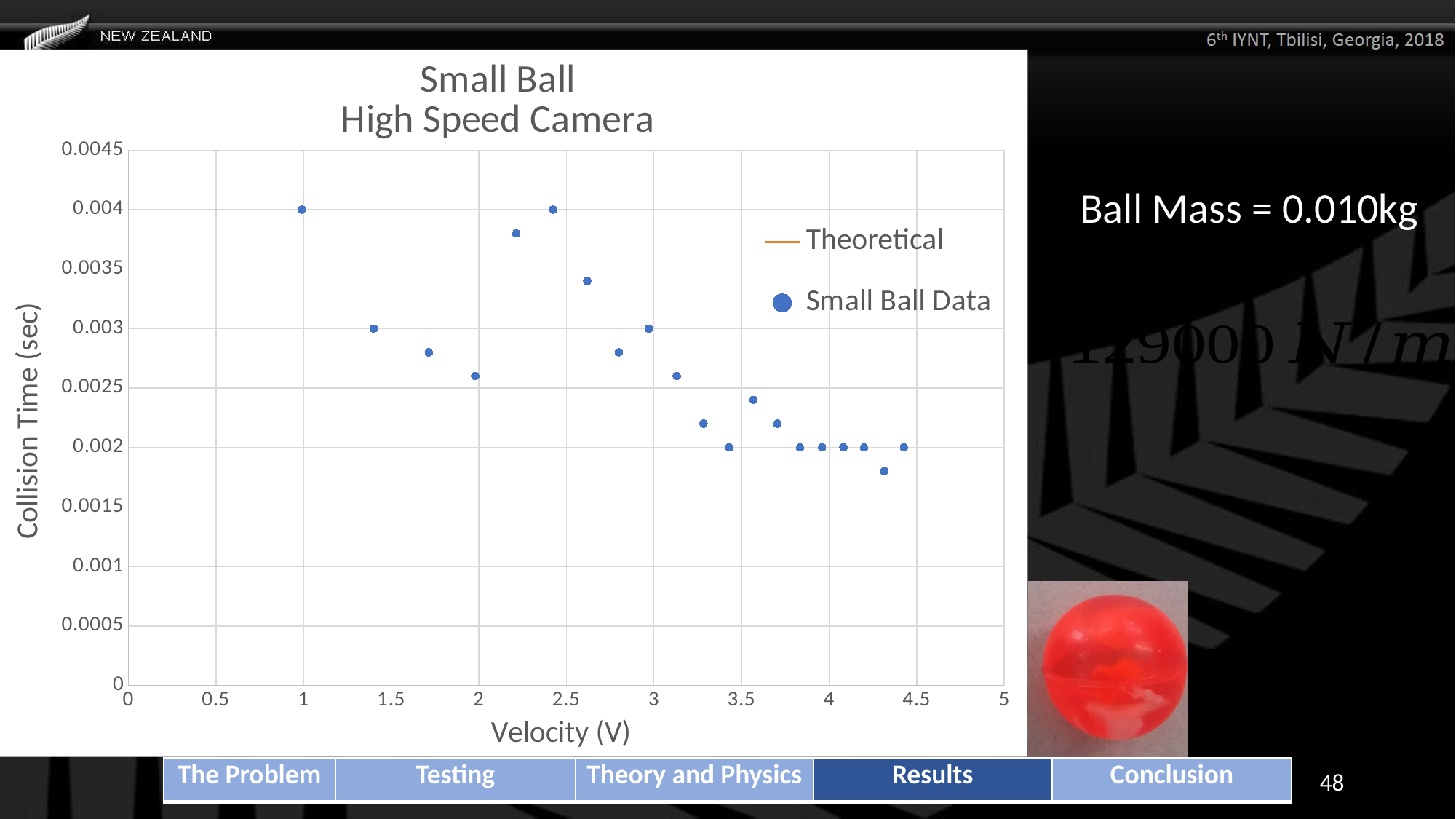
What is the highest collision time reached by any Small Ball Data point? 0.004 What is the title of the chart? Small Ball High Speed Camera Which has the larger collision time: the data point at a velocity of about 1 or the data point at a velocity of about 4? The point at a velocity of about 1 How many series does the chart legend list? 2 What is the label of the x axis? Velocity (V) What are the two entries in the chart legend? Theoretical and Small Ball Data Is the collision time for the data point at a velocity of about 1 greater or less than 0.0035? greater What is the label of the y axis? Collision Time (sec) Overall, does the collision time rise or fall as velocity increases along the x axis? Fall Is the collision time for the data point at a velocity of about 4.3 greater or less than 0.0025? less What kind of chart is shown on the slide? Scatter chart What is the maximum value shown on the y axis? 0.0045